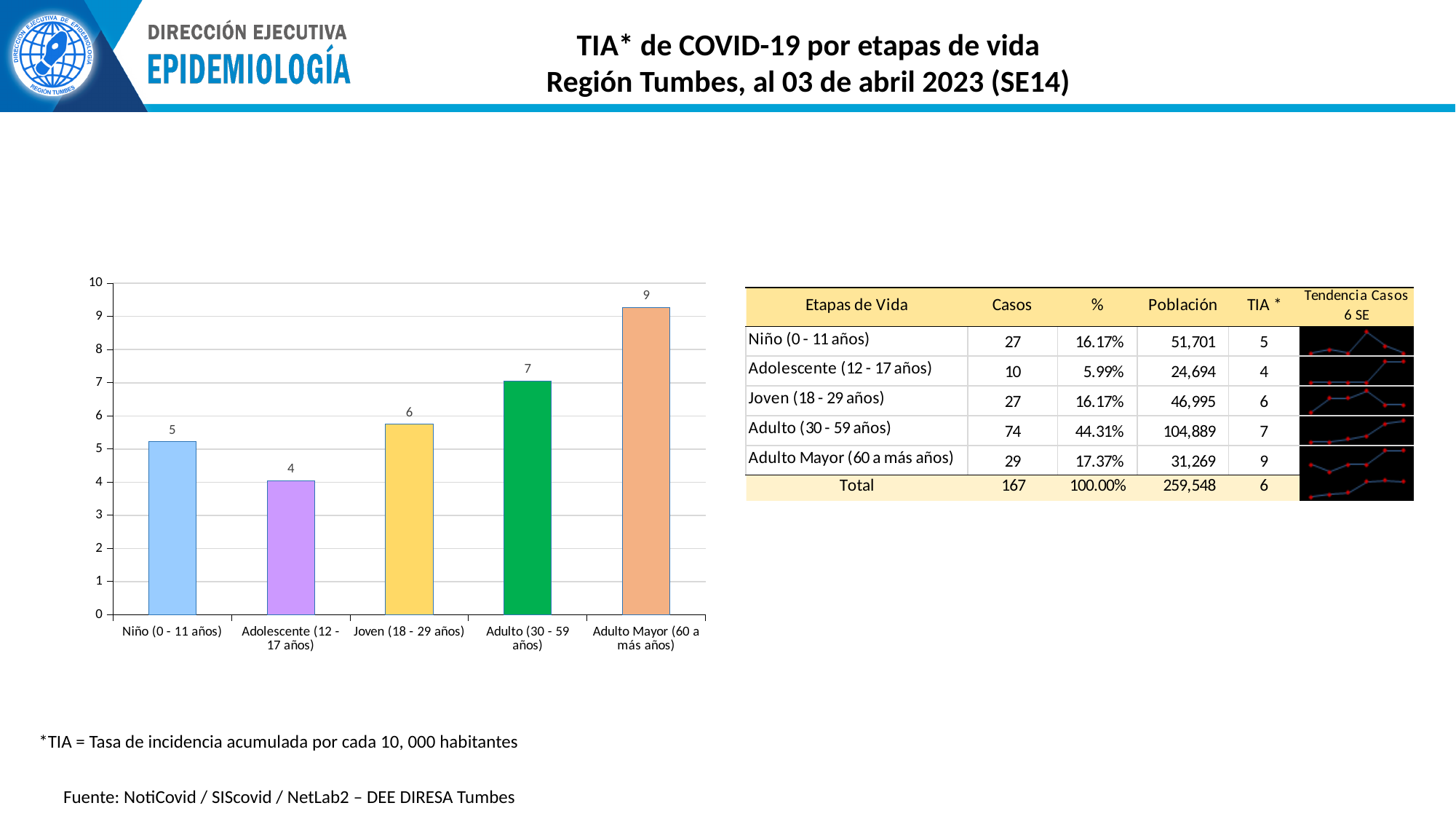
What type of chart is shown on the slide? bar chart What is the TIA value shown for Joven (18 - 29 años) on the bar chart? 6 Which category has the lowest TIA value on the bar chart? Adolescente (12 - 17 años) What is the difference between the TIA values for Adulto Mayor (60 a más años) and Adolescente (12 - 17 años) on the bar chart? 5 What colour is the bar for Adulto (30 - 59 años) on the bar chart? green How many categories (etapas de vida) are shown on the bar chart? 5 Which category has the highest TIA value on the bar chart? Adulto Mayor (60 a más años) What is the TIA value shown for Adulto Mayor (60 a más años) on the bar chart? 9 What is the TIA value shown for Adulto (30 - 59 años) on the bar chart? 7 What is the TIA value shown for Adolescente (12 - 17 años) on the bar chart? 4 What is the TIA value shown for Niño (0 - 11 años) on the bar chart? 5 Which has a larger TIA value on the bar chart, Joven (18 - 29 años) or Adulto (30 - 59 años)? Adulto (30 - 59 años)